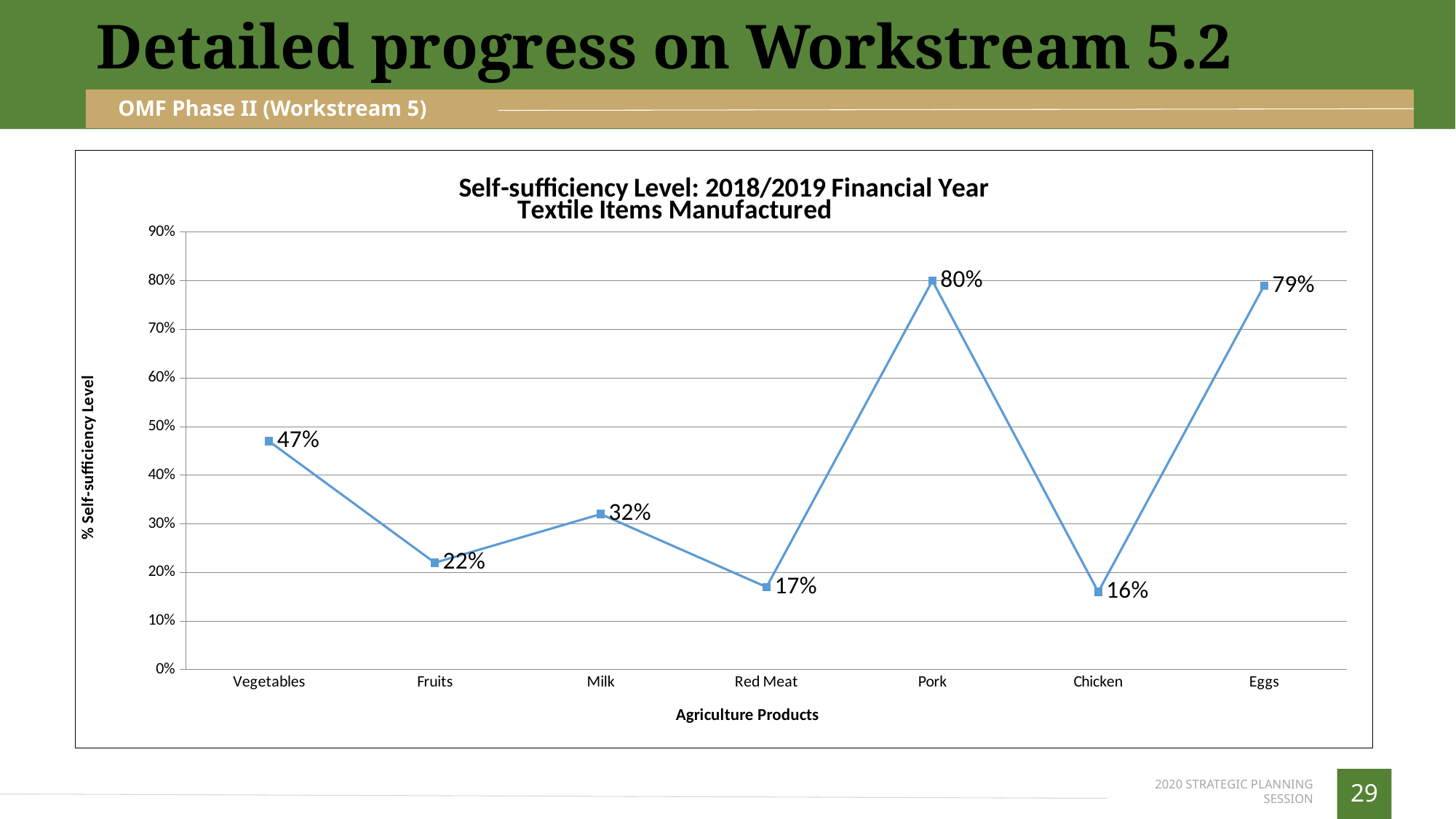
Does the self-sufficiency level rise or fall from Vegetables to Fruits? Fall What is the label of the x axis? Agriculture Products What is the self-sufficiency level for Vegetables? 47% What is the self-sufficiency level for Milk? 32% Which agriculture product has the lowest self-sufficiency level? Chicken What is the self-sufficiency level for Chicken? 16% Which has a higher self-sufficiency level, Vegetables or Milk? Vegetables Which agriculture product has the highest self-sufficiency level? Pork How many agriculture products are plotted on the chart? 7 What is the self-sufficiency level for Pork? 80% What is the difference between the self-sufficiency levels of Eggs and Fruits? 57% What kind of chart is shown on the slide? Line chart